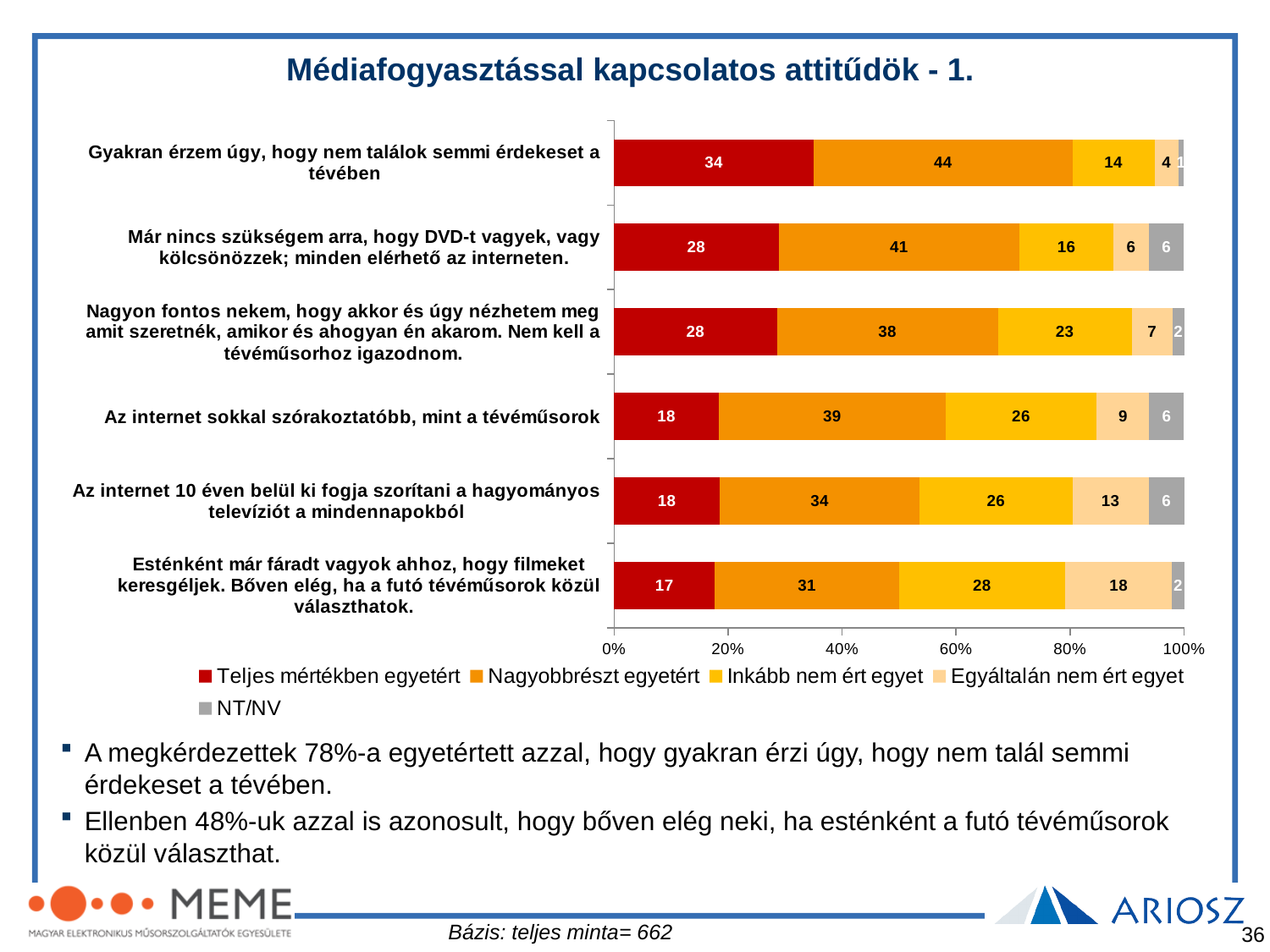
How many statements (categories) are plotted in the chart? 6 Which statement has the lowest 'Nagyobbrészt egyetért' value? Esténként már fáradt vagyok ahhoz, hogy filmeket keresgéljek. Bőven elég, ha a futó tévéműsorok közül választhatok. What is the difference between the 'Nagyobbrészt egyetért' values for 'Gyakran érzem úgy, hogy nem találok semmi érdekeset a tévében' and 'Már nincs szükségem arra, hogy DVD-t vagyek, vagy kölcsönözzek; minden elérhető az interneten.'? 3 How many series does the legend list? 5 What type of chart is shown on the slide? stacked bar chart What is the 'Nagyobbrészt egyetért' value for 'Az internet sokkal szórakoztatóbb, mint a tévéműsorok'? 39 Which is larger: the 'Inkább nem ért egyet' value for 'Nagyon fontos nekem, hogy akkor és úgy nézhetem meg amit szeretnék...' or for 'Az internet sokkal szórakoztatóbb, mint a tévéműsorok'? Az internet sokkal szórakoztatóbb, mint a tévéműsorok Which statement has the highest 'Teljes mértékben egyetért' value? Gyakran érzem úgy, hogy nem találok semmi érdekeset a tévében What is the 'Teljes mértékben egyetért' value for 'Gyakran érzem úgy, hogy nem találok semmi érdekeset a tévében'? 34 What is the 'Inkább nem ért egyet' value for 'Esténként már fáradt vagyok ahhoz, hogy filmeket keresgéljek. Bőven elég, ha a futó tévéműsorok közül választhatok.'? 28 What is the title of the chart on the slide? Médiafogyasztással kapcsolatos attitűdök - 1. What is the 'Egyáltalán nem ért egyet' value for 'Az internet 10 éven belül ki fogja szorítani a hagyományos televíziót a mindennapokból'? 13